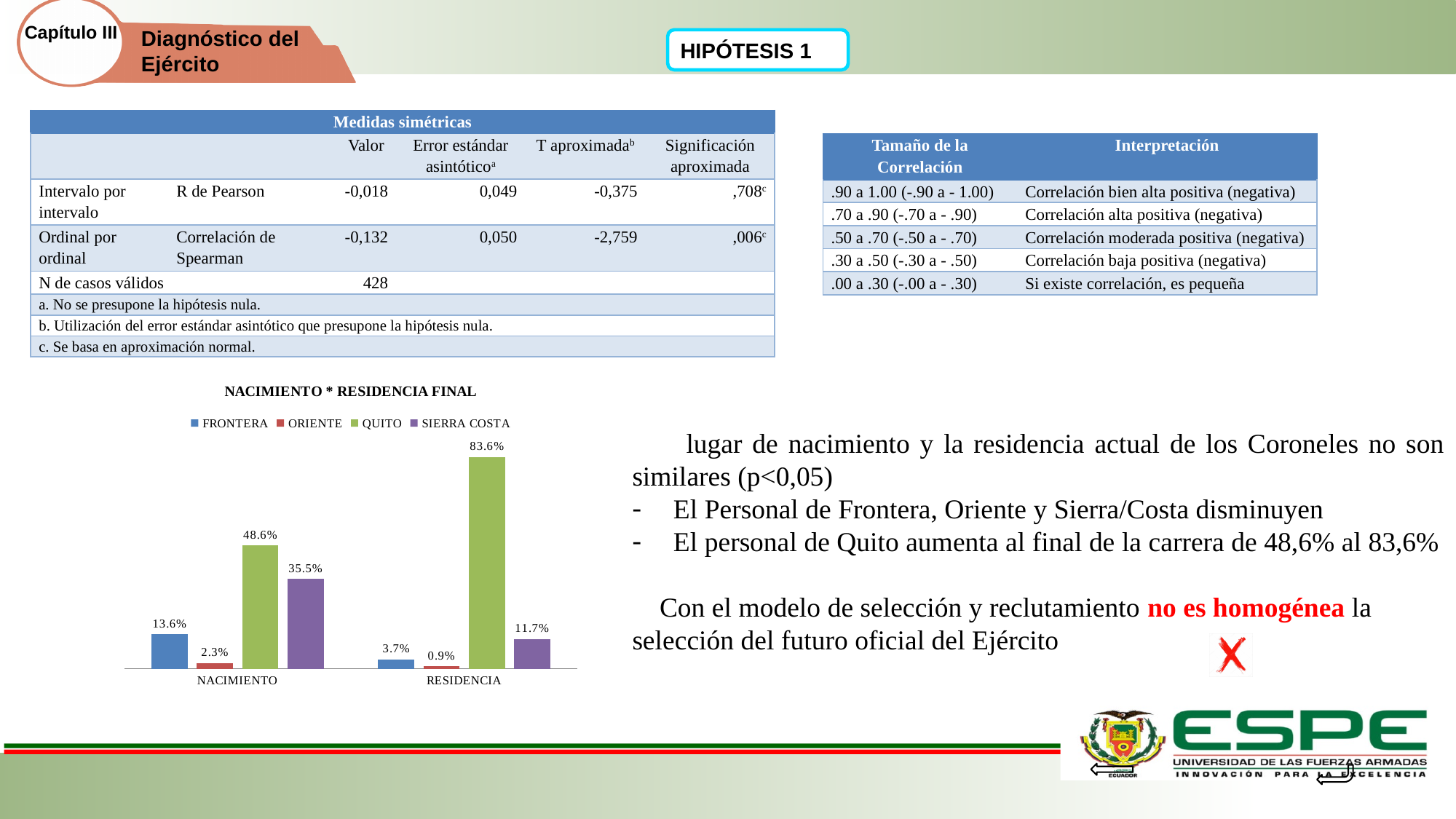
How many categories are shown on the x axis of the "NACIMIENTO * RESIDENCIA FINAL" chart? 2 What is the value for QUITO in the RESIDENCIA category? 83.6% Which series has the highest value in the RESIDENCIA category? QUITO Which is larger: FRONTERA in NACIMIENTO or SIERRA COSTA in RESIDENCIA? FRONTERA in NACIMIENTO Does the value for FRONTERA rise or fall from NACIMIENTO to RESIDENCIA? fall What is the difference between the QUITO values for RESIDENCIA and NACIMIENTO? 35.0% What is the value for QUITO in the NACIMIENTO category? 48.6% Which series has the lowest value in the NACIMIENTO category? ORIENTE What is the value for SIERRA COSTA in the NACIMIENTO category? 35.5% What type of chart is shown under the title "NACIMIENTO * RESIDENCIA FINAL"? bar chart How many series does the legend of the "NACIMIENTO * RESIDENCIA FINAL" chart list? 4 What is the value for ORIENTE in the RESIDENCIA category? 0.9%